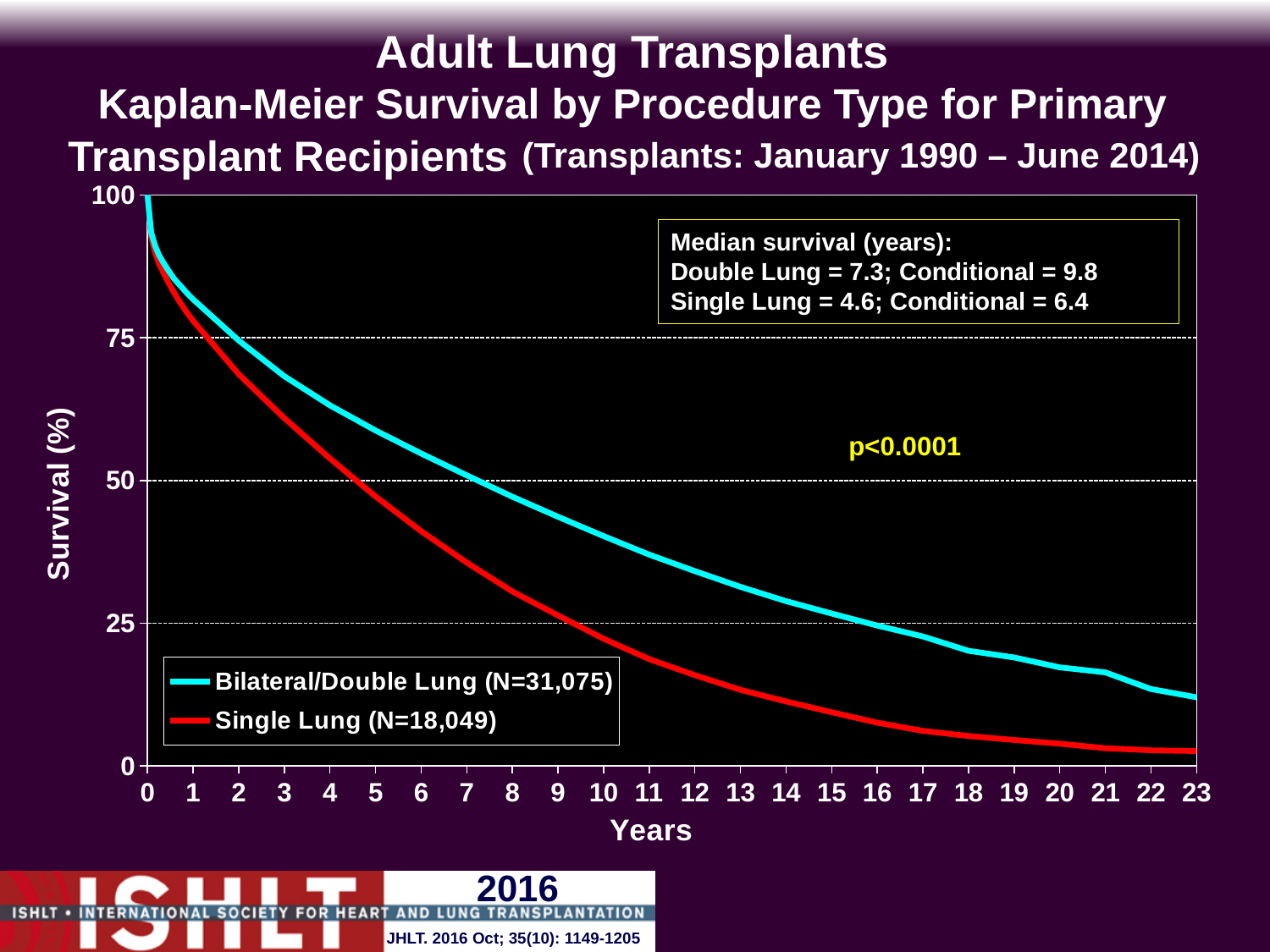
What is the median survival in years for Single Lung recipients? 4.6 How many series does the legend list? 2 Is the survival value for Single Lung at 6 years greater or less than 50? less What is the conditional median survival in years for Double Lung recipients? 9.8 Is the survival value for Bilateral/Double Lung at 1 year greater or less than 75? greater At 10 years, which group has the higher survival, Bilateral/Double Lung or Single Lung? Bilateral/Double Lung What is the median survival in years for Double Lung recipients? 7.3 What is the N for the Bilateral/Double Lung group shown in the legend? 31,075 Is the survival value for Bilateral/Double Lung at 20 years greater or less than 25? less Do the survival curves rise or fall as years increase? fall What is the conditional median survival in years for Single Lung recipients? 6.4 What kind of chart is shown on the slide? line chart